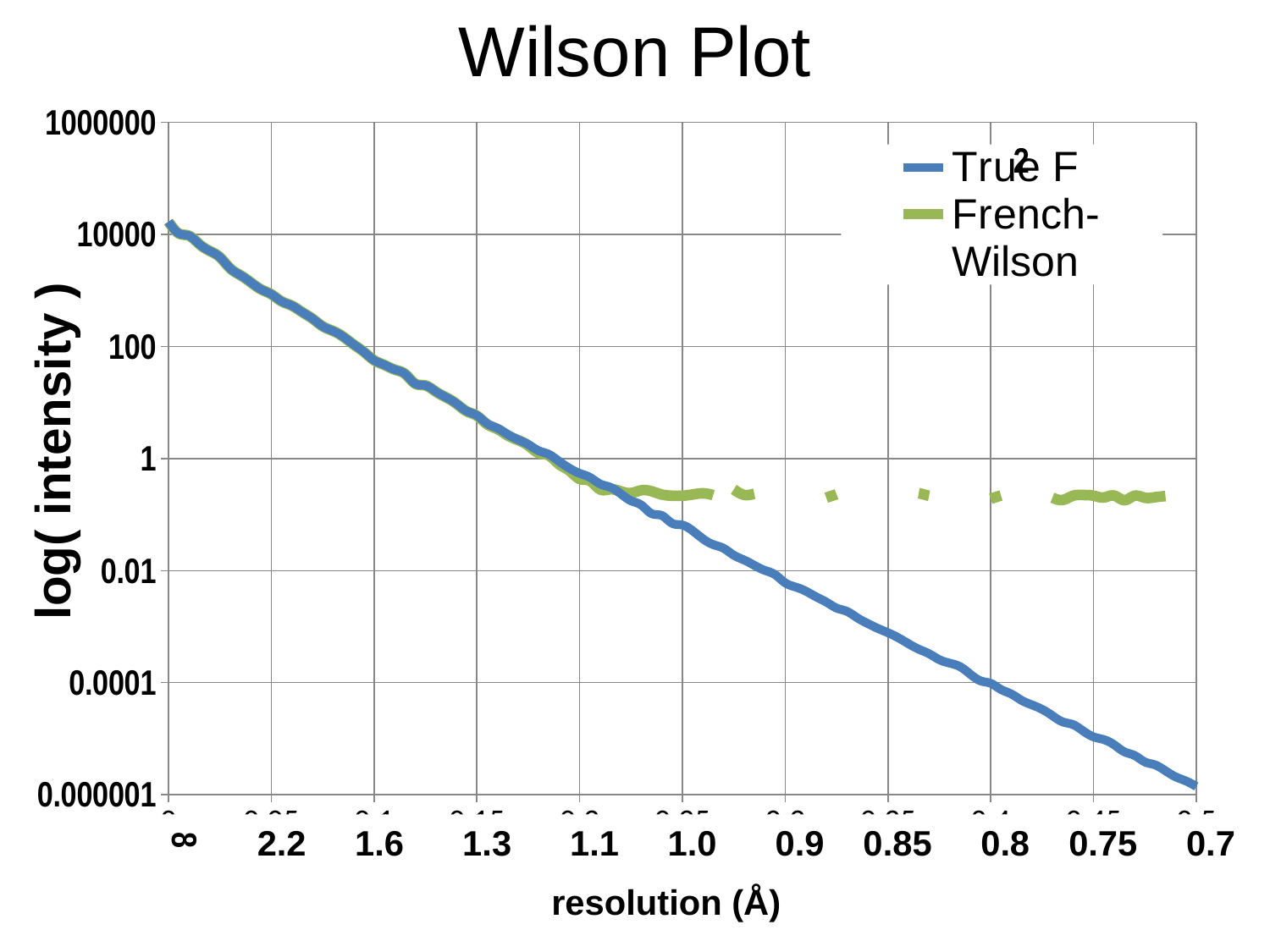
Is the value for True F² at resolution 0.8 Å greater or less than 0.01? less What kind of chart is shown on the slide? Line chart Is the value for True F² at resolution ∞ greater or less than 100? greater What is the title of the chart? Wilson Plot How many series does the legend list? 2 Is the value for True F² at resolution 0.7 Å greater or less than 0.01? less Does the True F² series rise or fall from left to right along the x axis? Fall What is the label of the x axis? resolution (Å) At resolution 0.8 Å, which series has the higher value, True F² or French-Wilson? French-Wilson